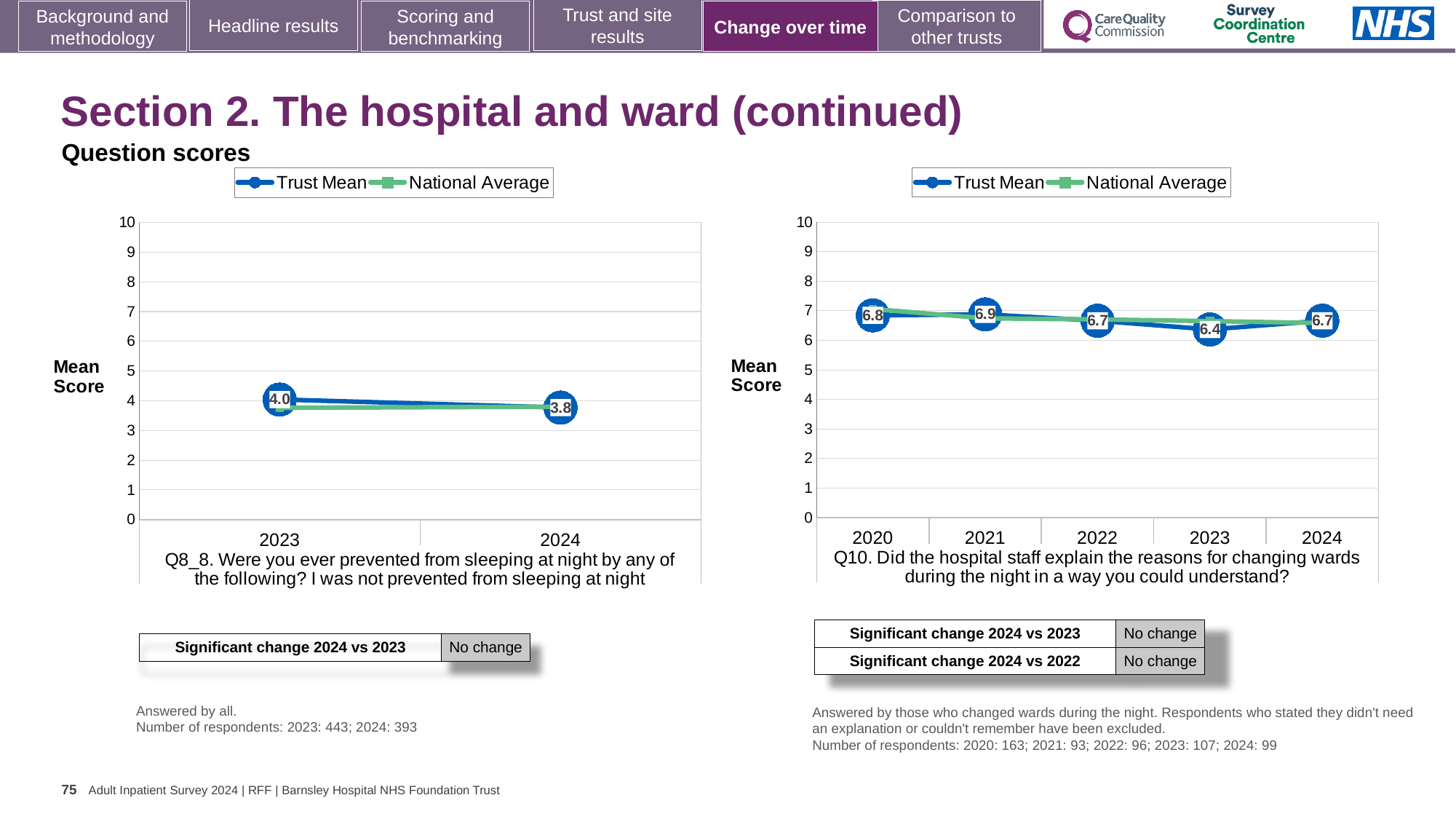
In the Q8_8 chart (left), what is the Trust Mean score for 2023? 4.0 In the Q10 chart (right), what is the Trust Mean score for 2023? 6.4 In the Q10 chart (right), is the Trust Mean score for 2020 greater or less than 5? greater In the Q8_8 chart (left), what is the Trust Mean score for 2024? 3.8 In the Q8_8 chart (left), does the Trust Mean rise or fall from 2023 to 2024? fall In the Q10 chart (right), what is the Trust Mean score for 2021? 6.9 In the Q8_8 chart (left), by how much did the Trust Mean score change from 2023 to 2024? 0.2 How many series does the legend of the Q8_8 chart (left) list? 2 In the Q10 chart (right), what is the difference between the Trust Mean scores for 2021 and 2023? 0.5 In the Q10 chart (right), which year has the lowest Trust Mean score? 2023 In the Q10 chart (right), which year has the highest Trust Mean score? 2021 In the Q10 chart (right), how many years are plotted on the x axis? 5